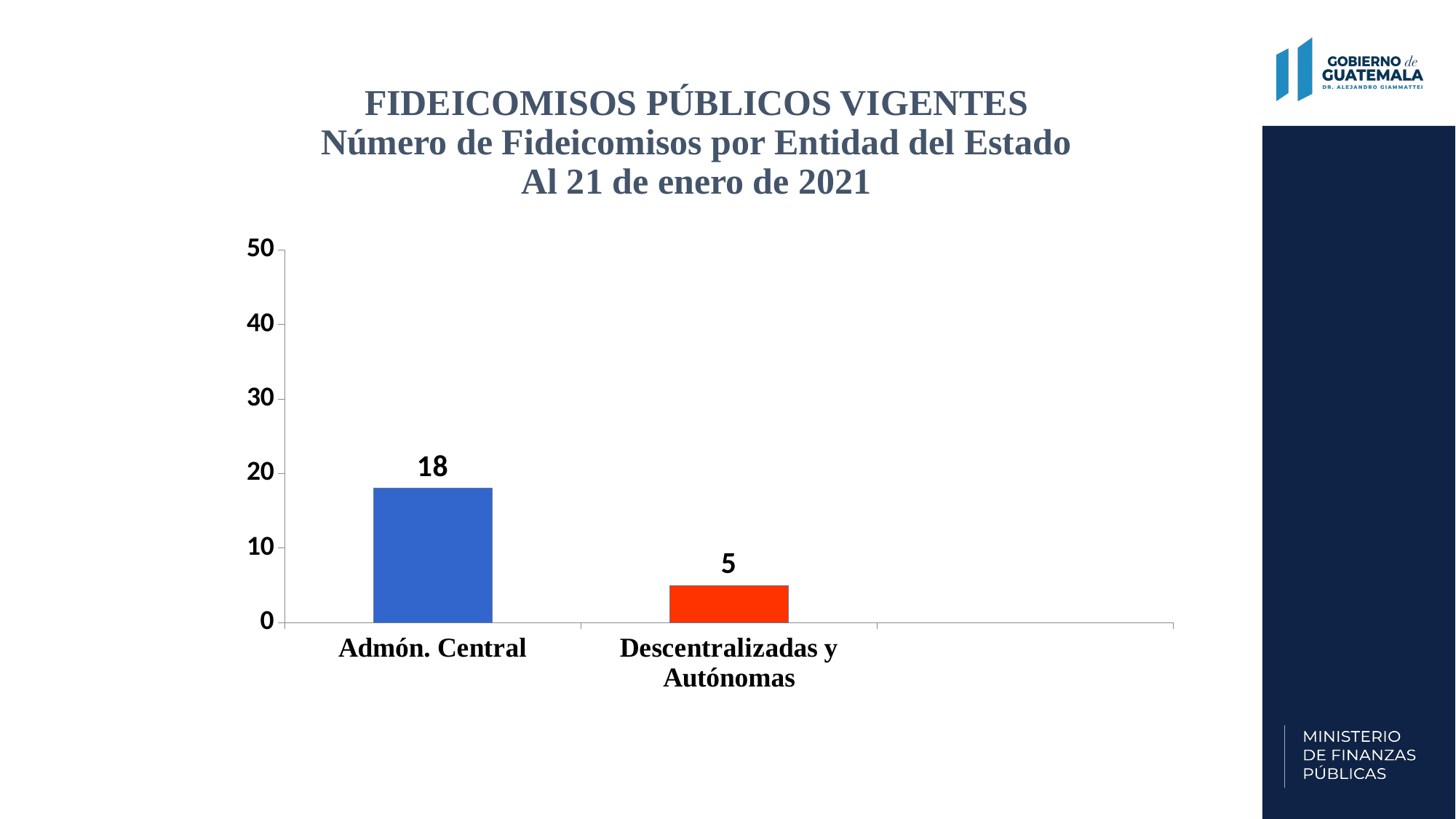
Is the value for Descentralizadas y Autónomas greater or less than 10? less What kind of chart is shown on the slide? bar chart Which is larger, the value for Admón. Central or the value for Descentralizadas y Autónomas? Admón. Central What colour is the bar for Descentralizadas y Autónomas? red What is the value for Admón. Central? 18 Which category has the lowest value? Descentralizadas y Autónomas What is the total of the two values shown in the chart? 23 Which category has the highest value? Admón. Central Is the value for Admón. Central greater or less than 20? less What is the difference between the values for Admón. Central and Descentralizadas y Autónomas? 13 What is the value for Descentralizadas y Autónomas? 5 How many categories are shown in the chart? 2